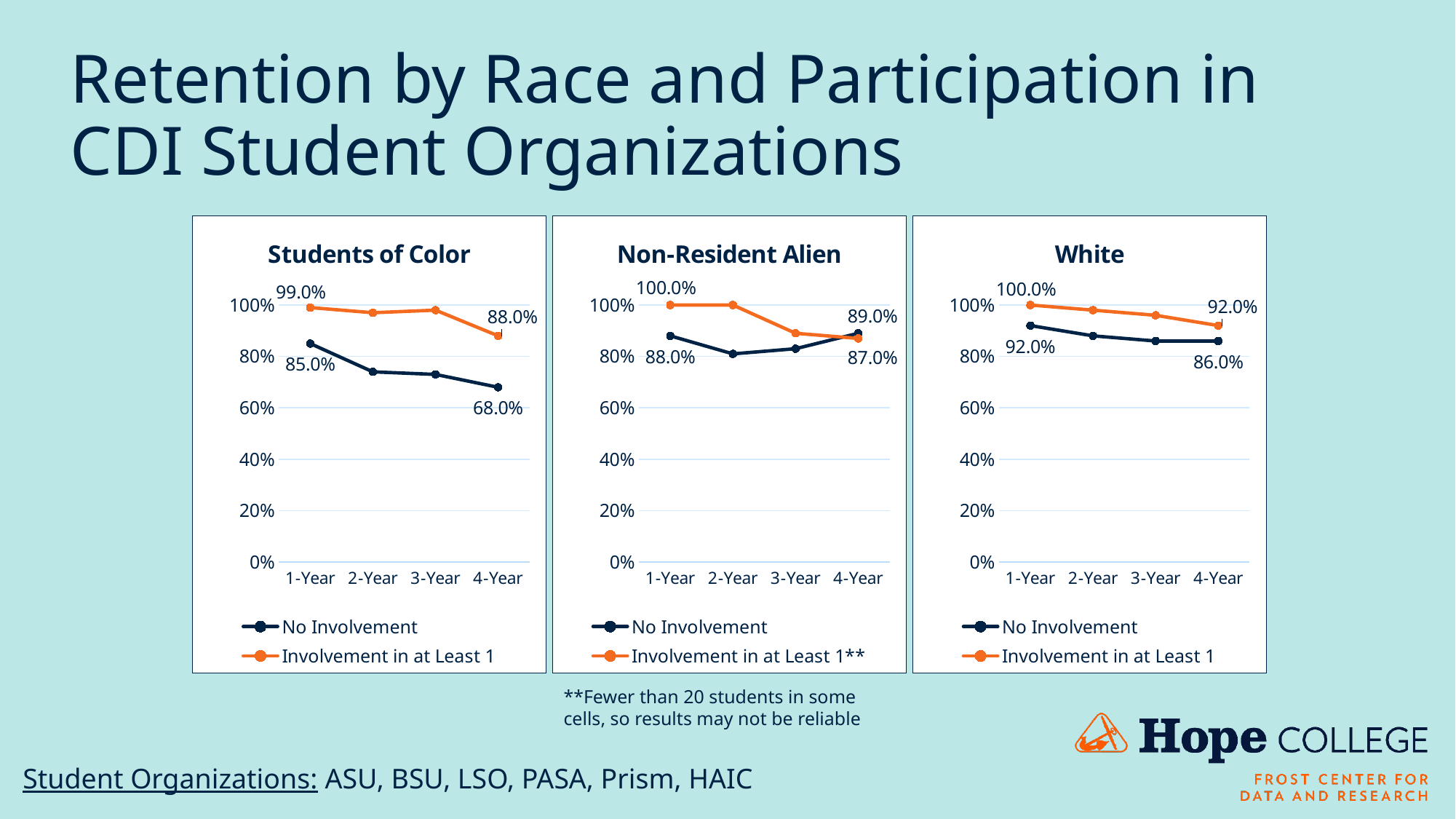
In the Students of Color chart, what is the 4-Year retention for No Involvement? 68.0% How many points are plotted along the x axis for each series in the White chart? 4 In the Non-Resident Alien chart, which series has the higher 4-Year retention? No Involvement In the Students of Color chart, what is the difference between the 1-Year and 4-Year retention for No Involvement? 17.0% In the White chart, what is the 4-Year retention for Involvement in at Least 1? 92.0% In the White chart, what is the difference between the 4-Year retention for Involvement in at Least 1 and No Involvement? 6.0% How many series does the legend of the Students of Color chart list? 2 In the Students of Color chart, is the 2-Year value for No Involvement greater or less than 80%? less In the White chart, does the No Involvement line rise or fall from 1-Year to 4-Year? Fall In the Non-Resident Alien chart, what is the 4-Year retention for No Involvement? 89.0% What kind of chart is the White chart? Line chart In the Students of Color chart, what is the 1-Year retention for Involvement in at Least 1? 99.0%